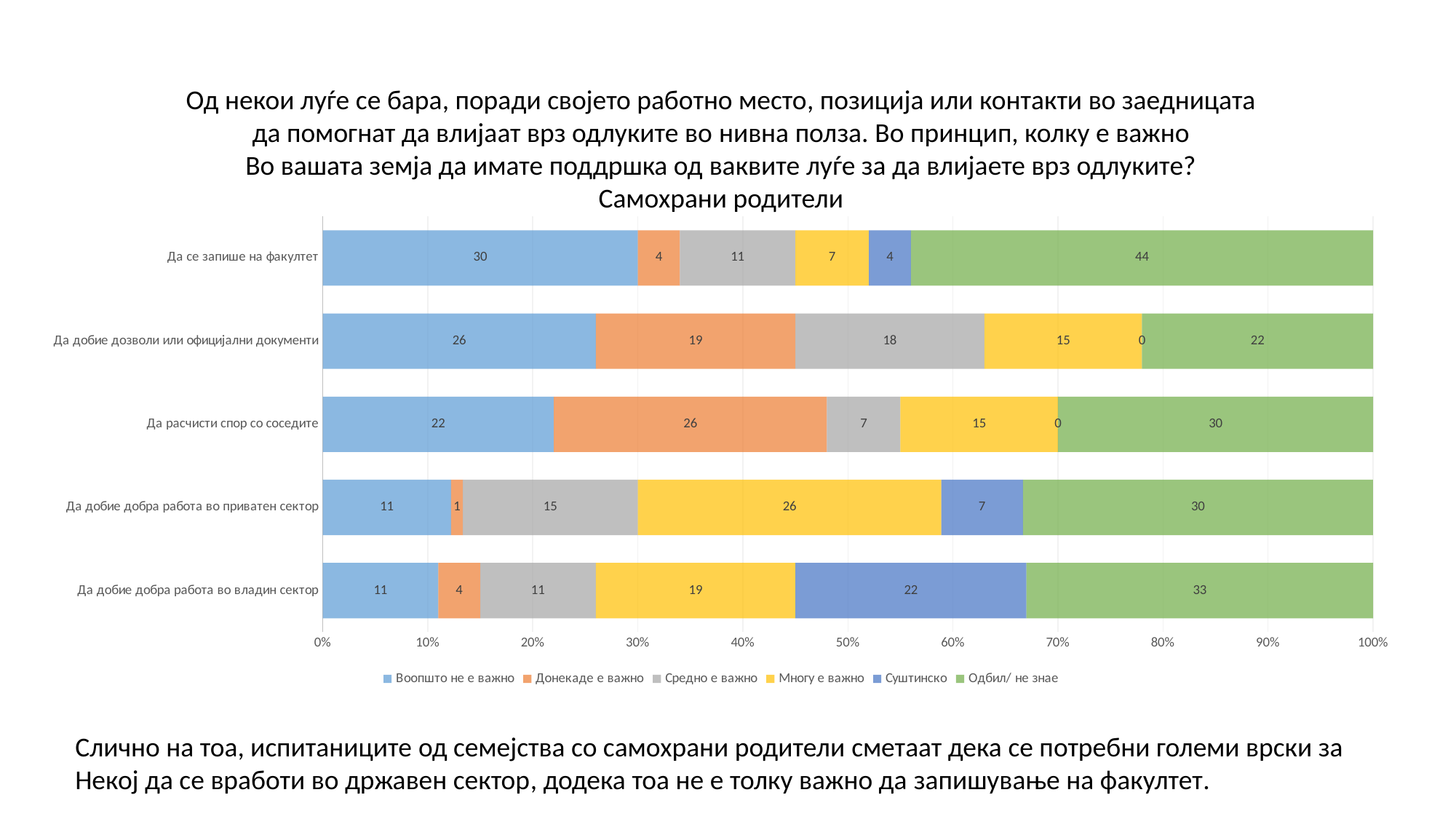
What is the value of 'Средно е важно' for 'Да добие дозволи или официјални документи'? 18 Which category has the highest value for 'Суштинско'? Да добие добра работа во владин сектор How many categories are shown on the chart? 5 What is the difference between the 'Одбил/ не знае' values for 'Да се запише на факултет' and 'Да добие добра работа во владин сектор'? 11 What is the value of 'Суштинско' for 'Да добие добра работа во владин сектор'? 22 What is the value of 'Воопшто не е важно' for 'Да се запише на факултет'? 30 What is the value of 'Донекаде е важно' for 'Да расчисти спор со соседите'? 26 Which category has the lowest value for 'Донекаде е важно'? Да добие добра работа во приватен сектор Which category has the highest value for 'Одбил/ не знае'? Да се запише на факултет What kind of chart is shown on the slide? Stacked bar chart Which has a larger 'Многу е важно' value: 'Да добие добра работа во приватен сектор' or 'Да добие добра работа во владин сектор'? Да добие добра работа во приватен сектор How many series does the legend list? 6